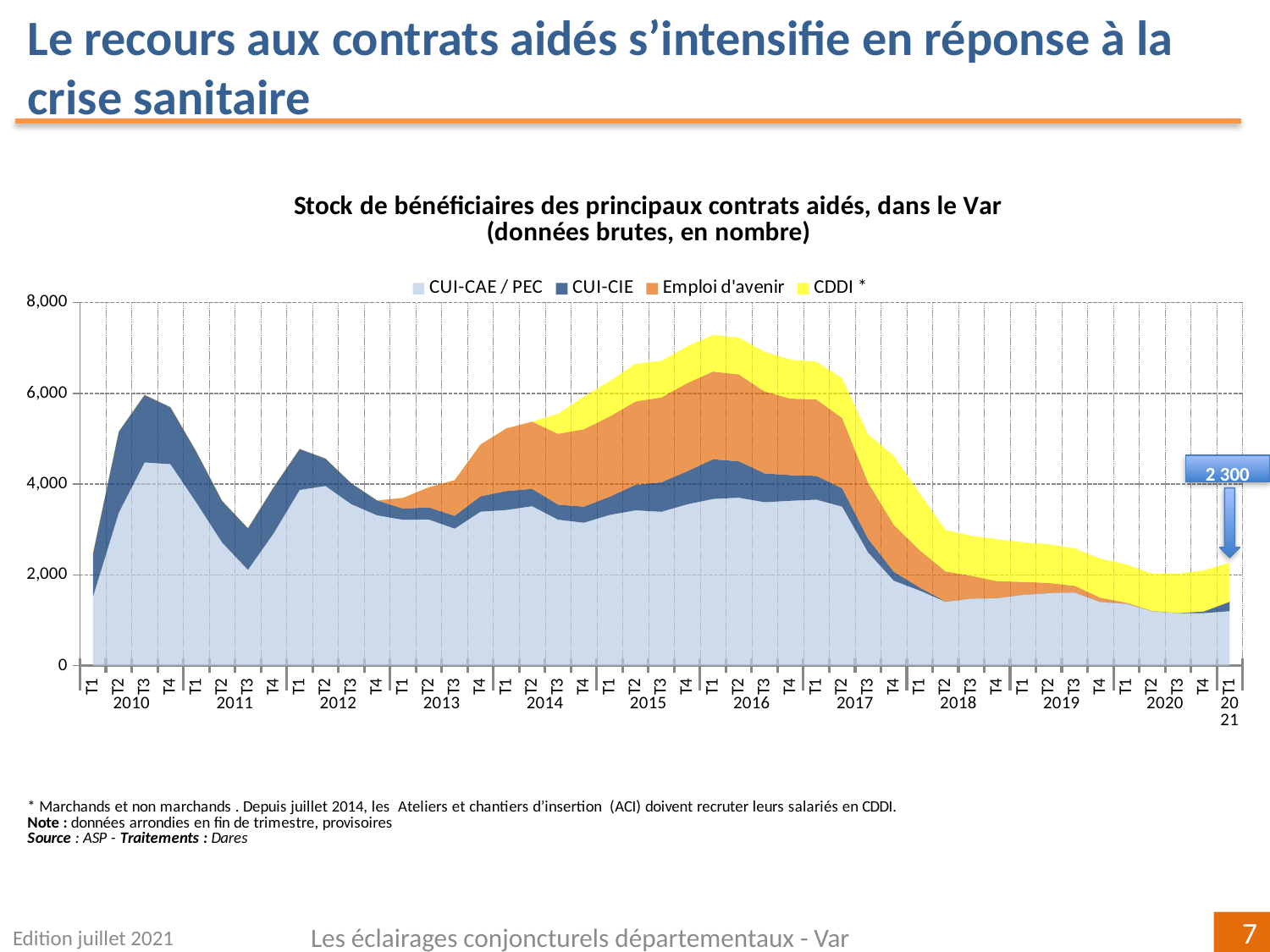
What total stock of beneficiaries is annotated for T1 2021? 2 300 How many series does the legend list? 4 Is the total stock of beneficiaries in T3 2010 greater or less than 4,000? greater Which is larger, the total stock of beneficiaries in T1 2016 or in T1 2021? T1 2016 How many years are labelled on the x axis? 12 In which year does the total stock of beneficiaries reach its highest level? 2016 Is the total stock of beneficiaries in T1 2016 greater or less than 6,000? greater Is the total stock of beneficiaries in T1 2021 greater or less than 2,000? greater What kind of chart is shown on the slide? area chart Does the total stock of beneficiaries rise or fall between 2016 and 2020? fall Which colour represents the CDDI * series in the legend? yellow